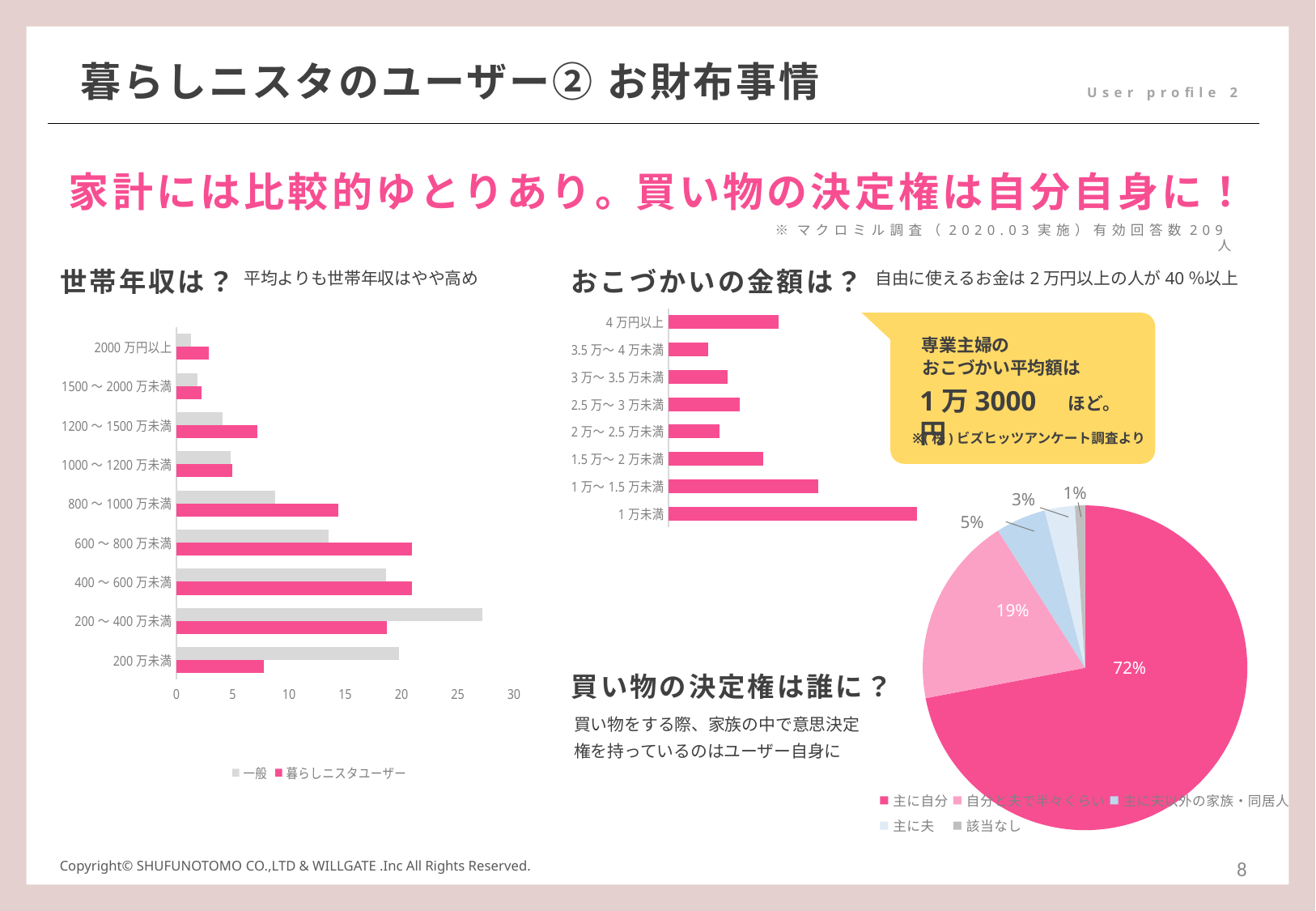
In the 買い物の決定権は誰に？ pie chart, which category has the smallest slice? 該当なし In the おこづかいの金額は？ chart, which category has the longest bar? 1万未満 In the 世帯年収は？ chart, for 200万未満, which series has the larger value, 一般 or 暮らしニスタユーザー? 一般 In the 世帯年収は？ chart, which category has the highest value for the 一般 series? 200～400万未満 How many categories are shown in the おこづかいの金額は？ chart? 8 How many series does the legend of the 世帯年収は？ chart list? 2 In the 世帯年収は？ chart, is the 暮らしニスタユーザー value for 200万未満 greater or less than 10? less In the 買い物の決定権は誰に？ pie chart, what share does 主に自分 have? 72% In the 買い物の決定権は誰に？ pie chart, what is the difference between the 主に自分 slice and the 自分と夫で半々くらい slice? 53% How many income categories are shown in the 世帯年収は？ chart? 9 What kind of chart is the 世帯年収は？ chart? bar chart In the 世帯年収は？ chart, is the 一般 value for 200～400万未満 greater or less than 25? greater